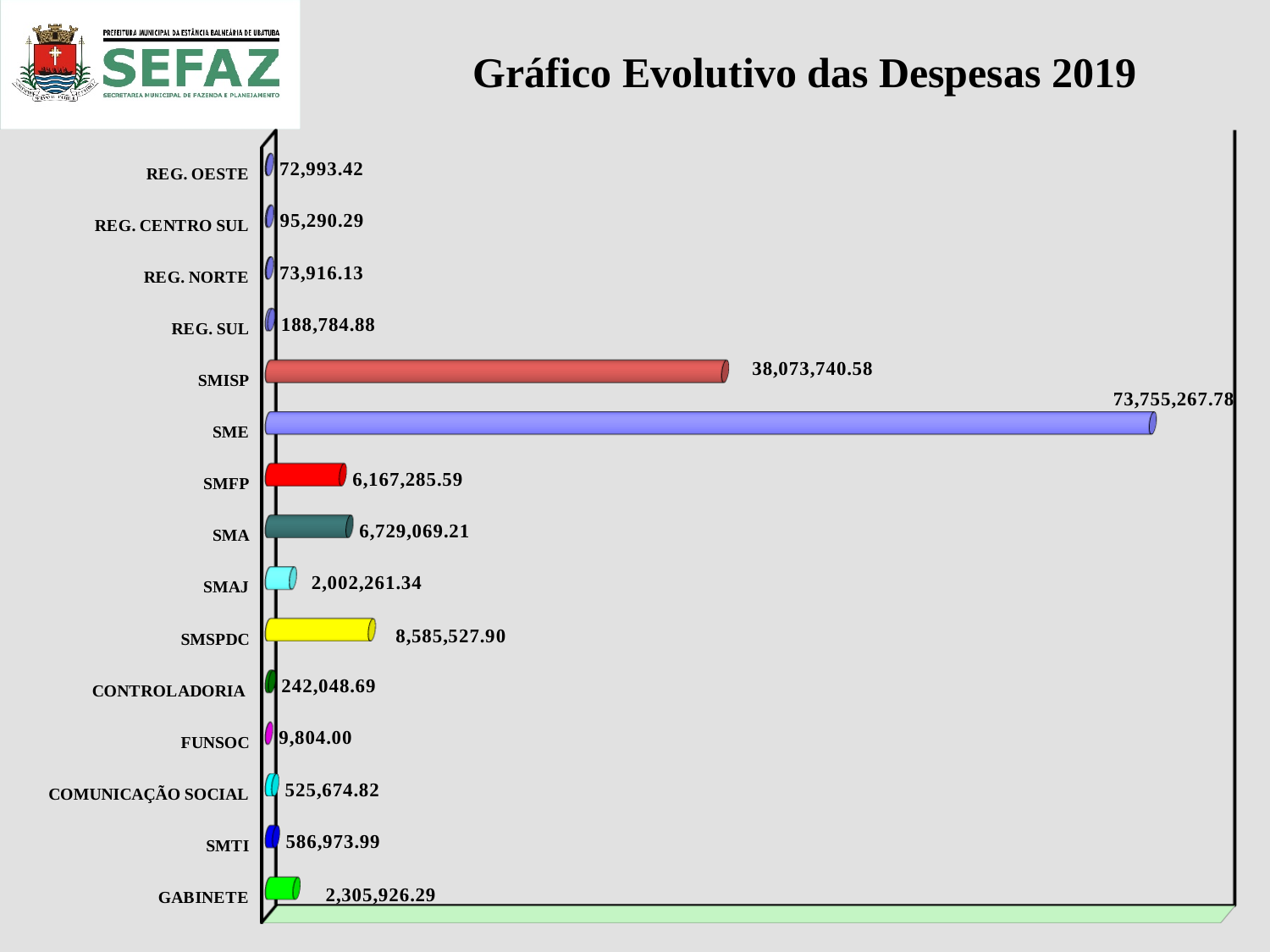
What is the value for SME? 73,755,267.78 What is the value for CONTROLADORIA? 242,048.69 What is the value for SMISP? 38,073,740.58 Which category has the highest value? SME Which category has the lowest value? FUNSOC What is the value for REG. CENTRO SUL? 95,290.29 What is the title of the chart? Gráfico Evolutivo das Despesas 2019 What is the difference between the values for SMA and SMFP? 561,783.62 What kind of chart is shown on the slide? Bar chart Which is larger, the value for GABINETE or the value for SMAJ? GABINETE How many categories are shown in the chart? 15 What is the difference between the values for SME and SMISP? 35,681,527.20